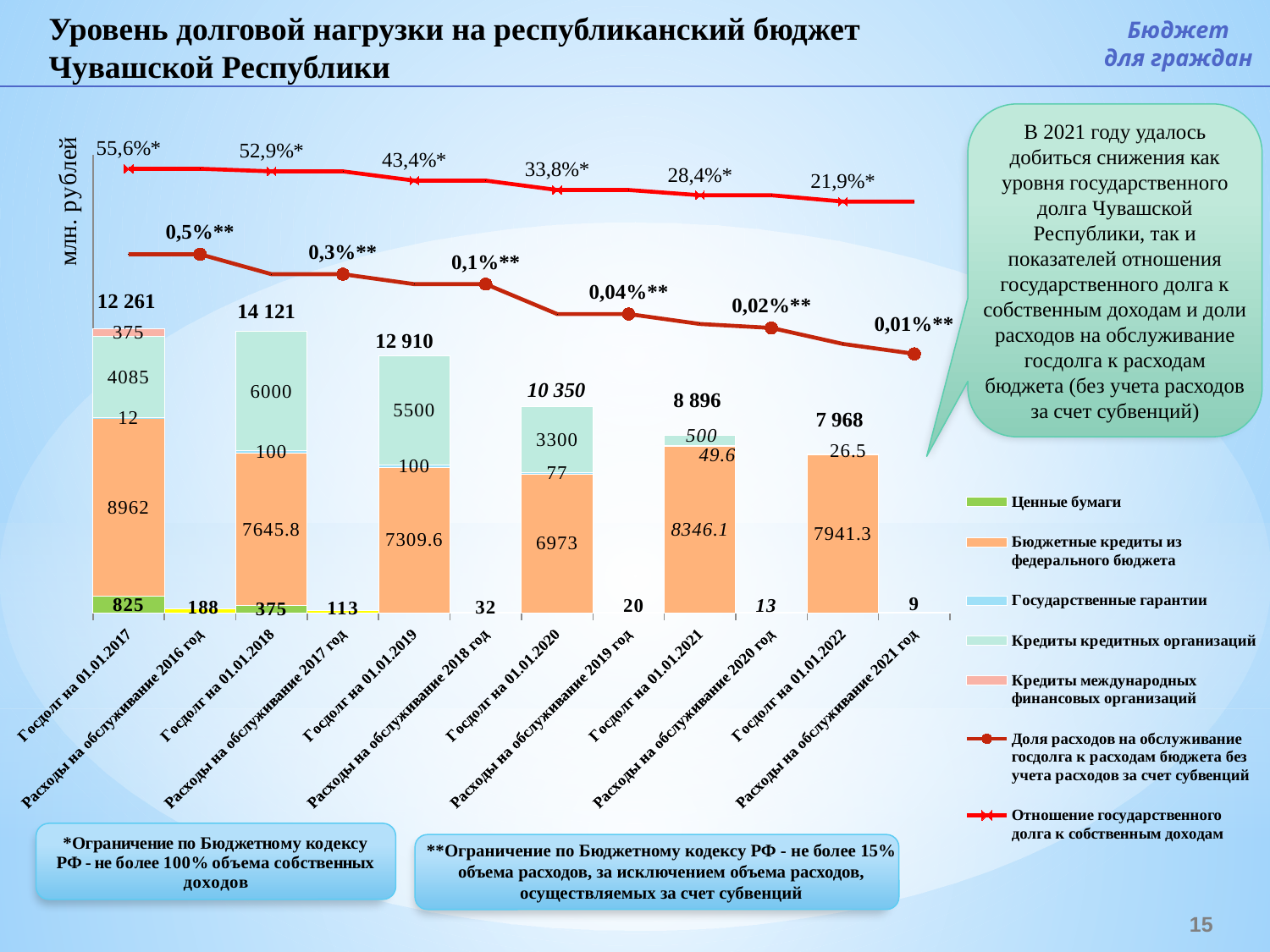
Which is larger: 'Бюджетные кредиты из федерального бюджета' on 01.01.2017 or on 01.01.2020? 01.01.2017 What is the total state debt (Госдолг) shown for 01.01.2018? 14 121 Which date has the highest total state debt (Госдолг) bar? Госдолг на 01.01.2018 What is the value of 'Бюджетные кредиты из федерального бюджета' in the bar for Госдолг на 01.01.2021? 8346.1 What is the value shown for 'Расходы на обслуживание 2016 год'? 188 What is the value of 'Доля расходов на обслуживание госдолга к расходам бюджета' at 01.01.2020? 0,04% Does the line 'Отношение государственного долга к собственным доходам' rise or fall from left to right? Falls What is the value of 'Кредиты кредитных организаций' in the bar for Госдолг на 01.01.2019? 5500 How many entries does the legend list? 7 Which date has the lowest total state debt (Госдолг) bar? Госдолг на 01.01.2022 What is the difference between the total state debt on 01.01.2017 (12 261) and on 01.01.2022 (7 968)? 4 293 What is the value of 'Отношение государственного долга к собственным доходам' at the last point (01.01.2022)? 21,9%